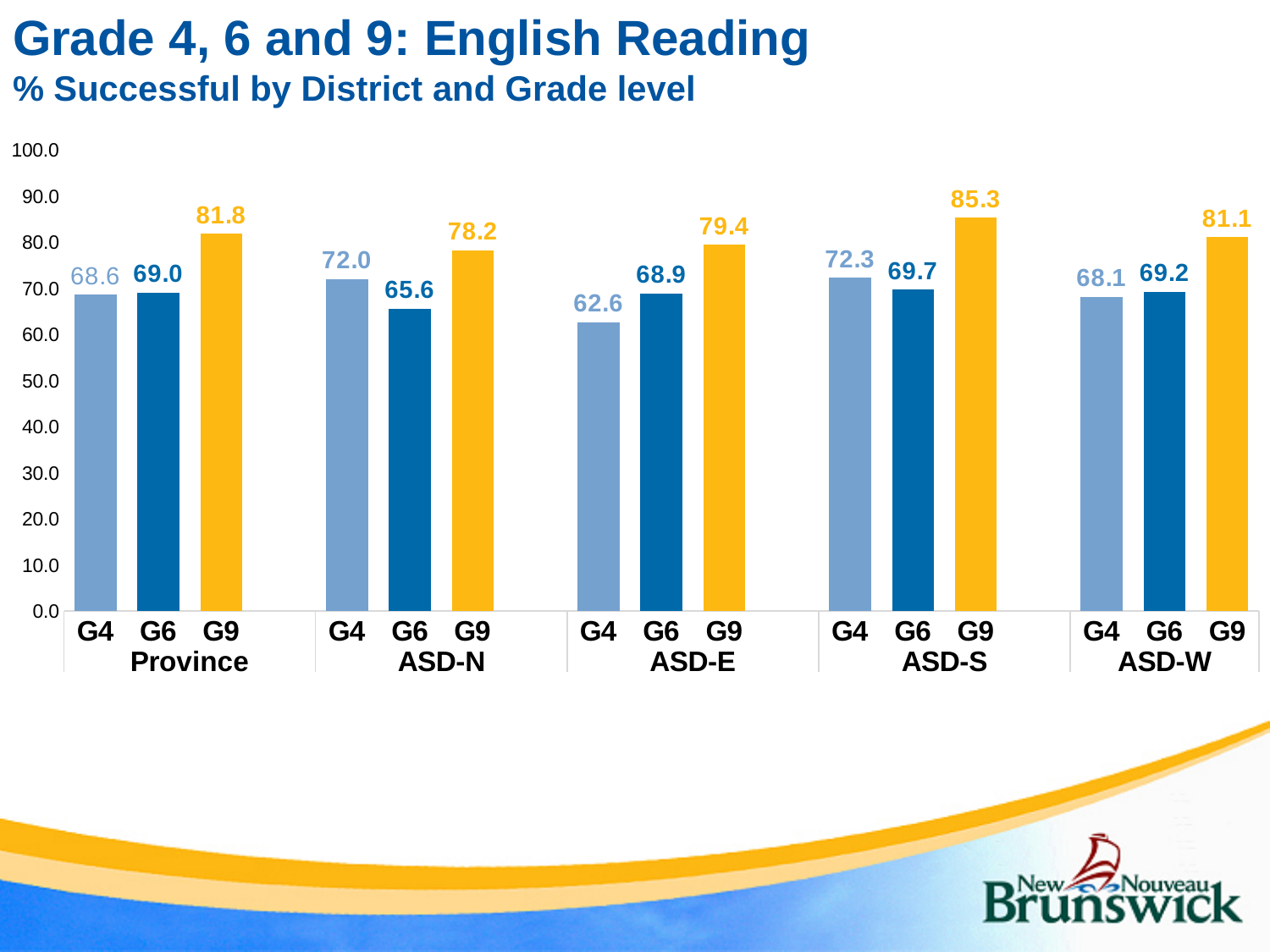
Which district group has the lowest G4 value? ASD-E How many district groups are shown on the x axis? 5 What is the difference between the G9 and G4 values in ASD-S? 13.0 Which district group has the highest G9 value? ASD-S How many bars are plotted in total on the chart? 15 What is the subtitle of the chart? % Successful by District and Grade level What is the value for G4 in ASD-E? 62.6 Which is larger, the G6 value in ASD-N or the G6 value in ASD-W? G6 in ASD-W What is the value for G6 in the Province group? 69.0 Is the value for G9 in ASD-N greater or less than 80.0? less What is the value for G9 in ASD-S? 85.3 What kind of chart is shown on the slide? Bar chart